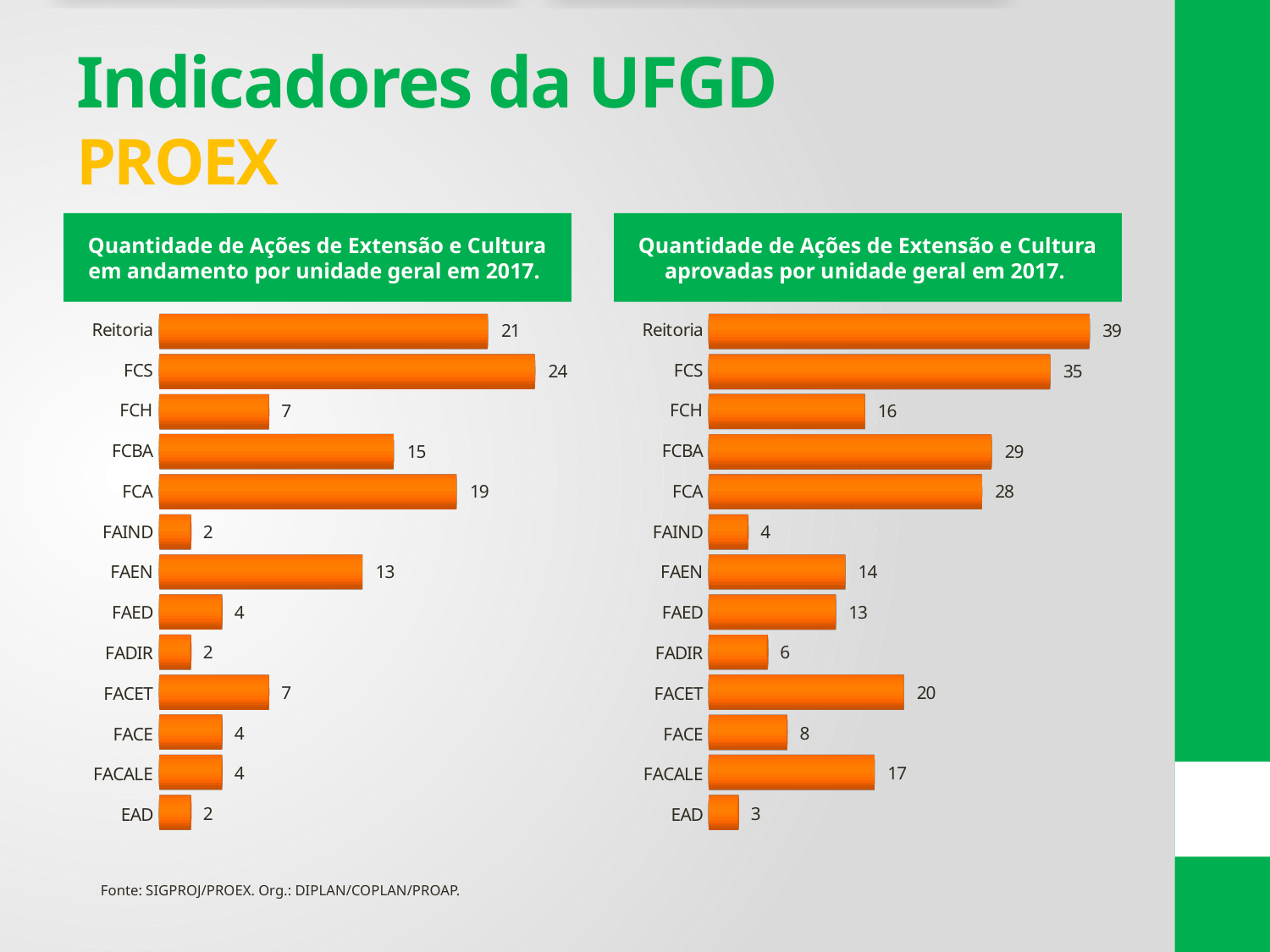
In the left chart (ações em andamento), which is larger, FAEN or FCH? FAEN In the right chart (ações aprovadas), which unit has the lowest value? EAD In the right chart (ações aprovadas), which unit has the highest value? Reitoria In the right chart (ações aprovadas), what is the value for FCBA? 29 What type of chart is the right chart (ações aprovadas)? Bar chart What is the title of the left chart? Quantidade de Ações de Extensão e Cultura em andamento por unidade geral em 2017. In the left chart (ações em andamento), what is the value for FCS? 24 In the left chart (ações em andamento), which unit has the highest value? FCS In the right chart (ações aprovadas), which is larger, FACET or FACALE? FACET How many units are shown in the left chart (ações em andamento)? 13 In the right chart (ações aprovadas), what is the difference between Reitoria and FCS? 4 In the left chart (ações em andamento), what is the difference between FCA and FCBA? 4